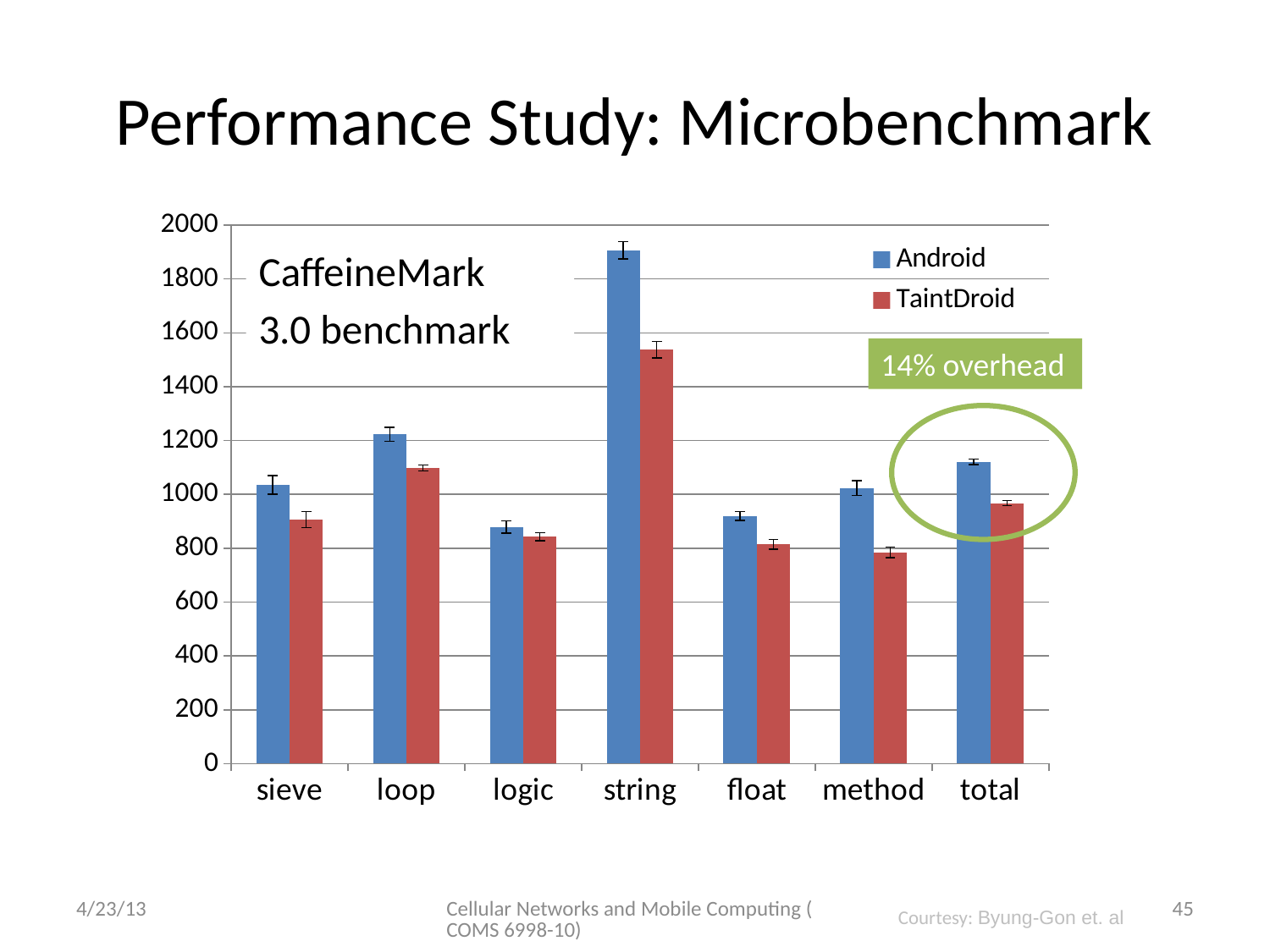
How many series does the legend list? 2 How many benchmark categories are shown on the x axis? 7 Is the Android value for string greater or less than 1800? greater Is the TaintDroid value for sieve greater or less than 1000? less Which category has the highest Android value? string What kind of chart is shown on the slide? bar chart Which is larger: the Android value for loop or the Android value for sieve? loop Which category has the highest TaintDroid value? string Is the Android value for total greater or less than 1000? greater What overhead percentage is annotated on the chart? 14% overhead For the string benchmark, which is larger: the Android value or the TaintDroid value? Android What are the two series named in the legend? Android and TaintDroid